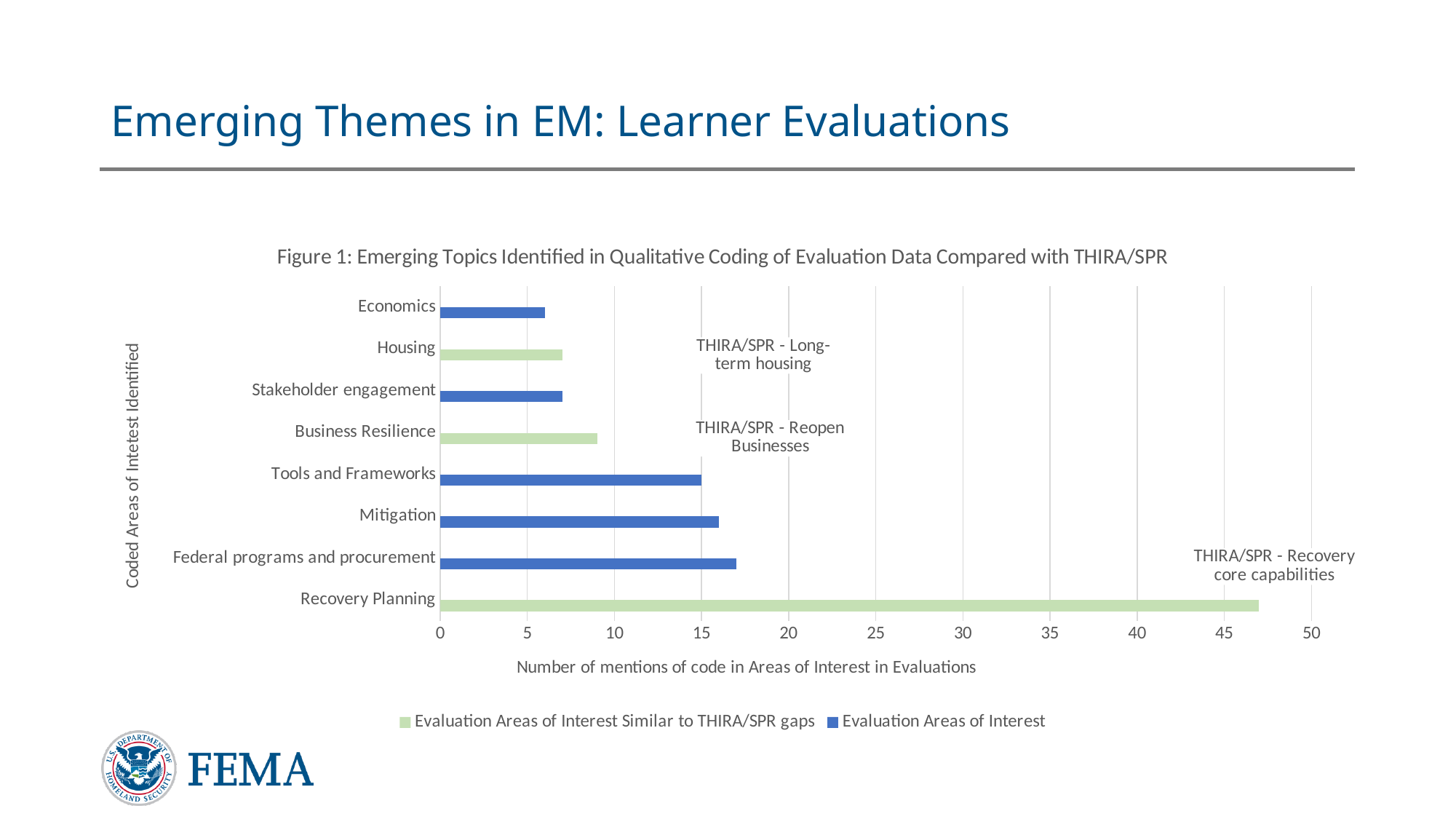
Is the value for Mitigation greater or less than 20? less Is the value for Federal programs and procurement greater or less than 15? greater What kind of chart is shown on the slide? bar chart Is the value for Business Resilience greater or less than 10? less Which coded area of interest has the highest number of mentions? Recovery Planning What is the title of the chart? Figure 1: Emerging Topics Identified in Qualitative Coding of Evaluation Data Compared with THIRA/SPR How many series does the chart legend list? 2 Which has more mentions, Federal programs and procurement or Economics? Federal programs and procurement How many coded areas of interest are listed on the y axis of the chart? 8 Which series is shown in green in the chart legend? Evaluation Areas of Interest Similar to THIRA/SPR gaps